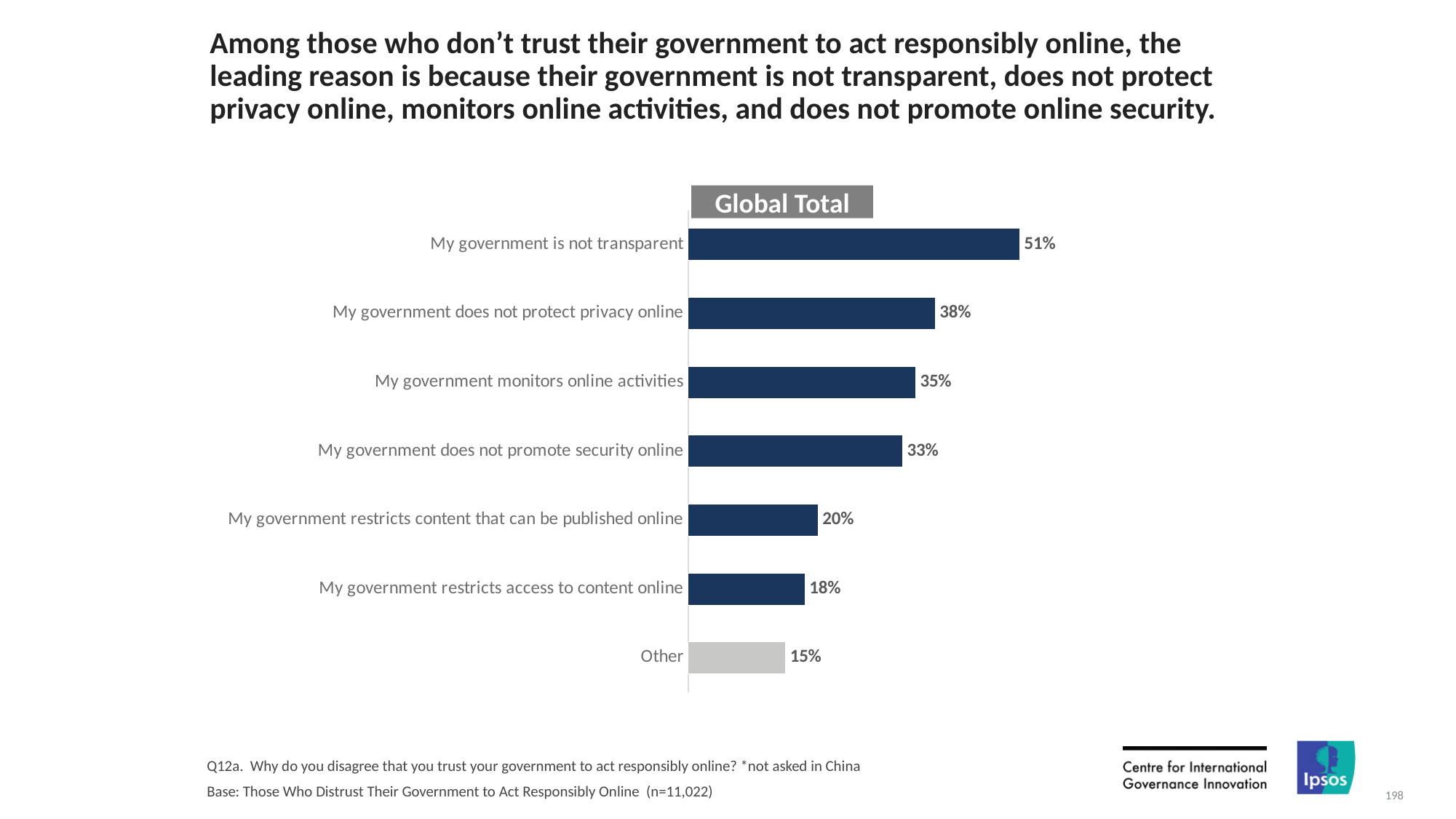
Which category has the highest value? My government is not transparent Which category has the lowest value? Other How many categories are shown in the chart? 7 What kind of chart is shown on the slide? Bar chart What is the value for "Other"? 15% What is the value for "My government is not transparent"? 51% Which is larger: "My government monitors online activities" or "My government does not promote security online"? My government monitors online activities What is the value for "My government does not protect privacy online"? 38% What is the value for "My government restricts access to content online"? 18% What is the difference between "My government is not transparent" and "My government does not protect privacy online"? 13% What is the difference between "My government restricts content that can be published online" and "My government restricts access to content online"? 2% What is the label shown above the chart? Global Total